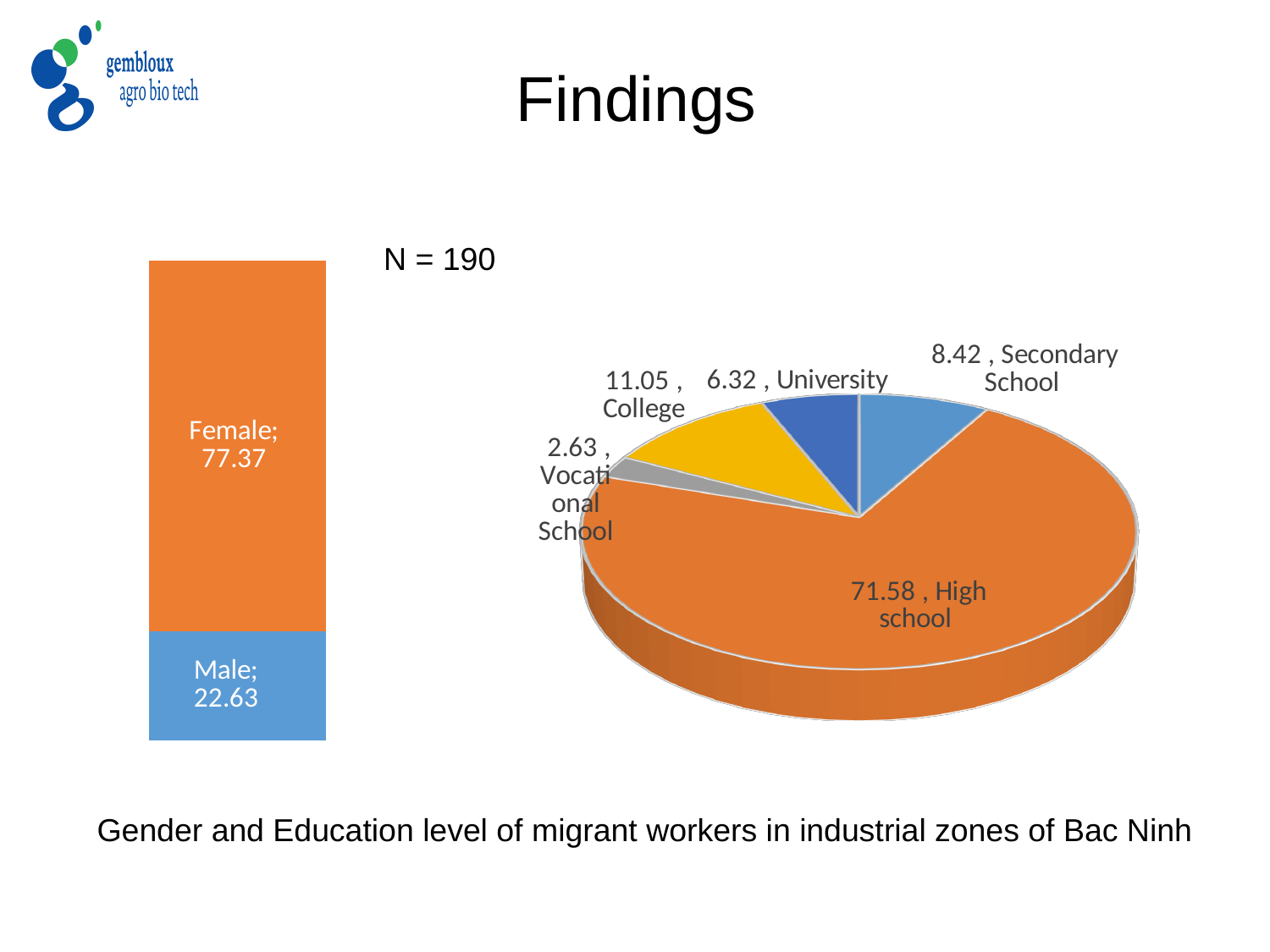
In the pie chart on the right, what is the difference between the Secondary School and University values? 2.10 In the pie chart on the right, which category has the smallest slice? Vocational School In the stacked bar chart on the left, what is the value for Female? 77.37 In the pie chart on the right, what is the value for Vocational School? 2.63 In the pie chart on the right, what is the value for High school? 71.58 In the pie chart on the right, what is the value for College? 11.05 In the stacked bar chart on the left, what is the value for Male? 22.63 In the stacked bar chart on the left, what is the total of the stacked bar? 100 In the stacked bar chart on the left, which is larger, Female or Male? Female In the pie chart on the right, how many categories are shown? 5 In the pie chart on the right, which category has the largest slice? High school In the stacked bar chart on the left, what is the difference between the Female and Male values? 54.74